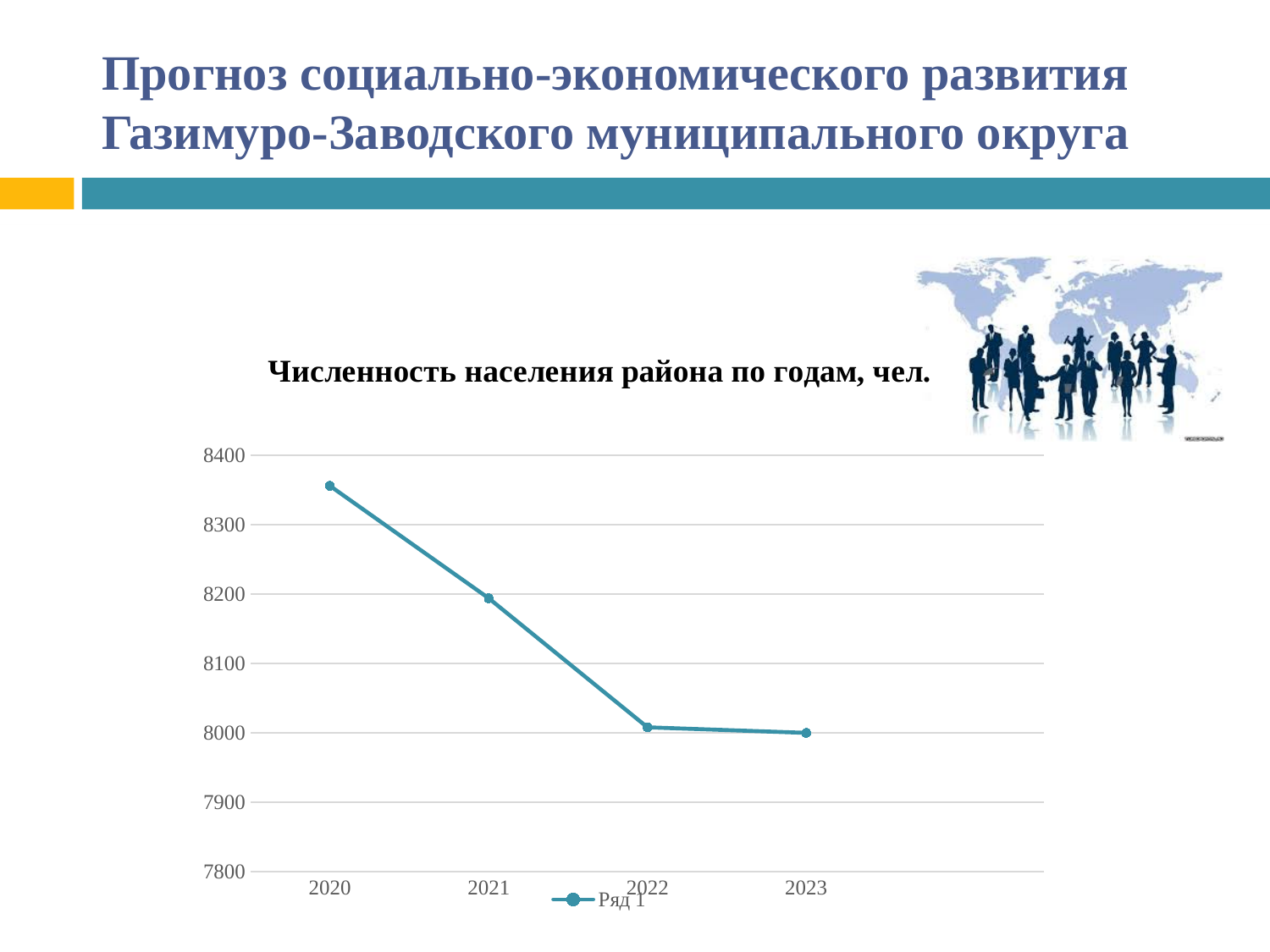
Which is larger, the value for 2020 or the value for 2022? 2020 What is the name of the series shown in the legend? Ряд 1 Is the value for 2023 greater or less than 8200? less Do the values rise or fall from 2020 to 2023? fall Is the value for 2021 greater or less than 8100? greater How many series does the legend list? 1 What kind of chart is shown on the slide? line chart What is the title of the chart? Численность населения района по годам, чел. Is the value for 2022 greater or less than 8100? less Which year has the highest population value on the chart? 2020 How many years (data points) are plotted on the chart? 4